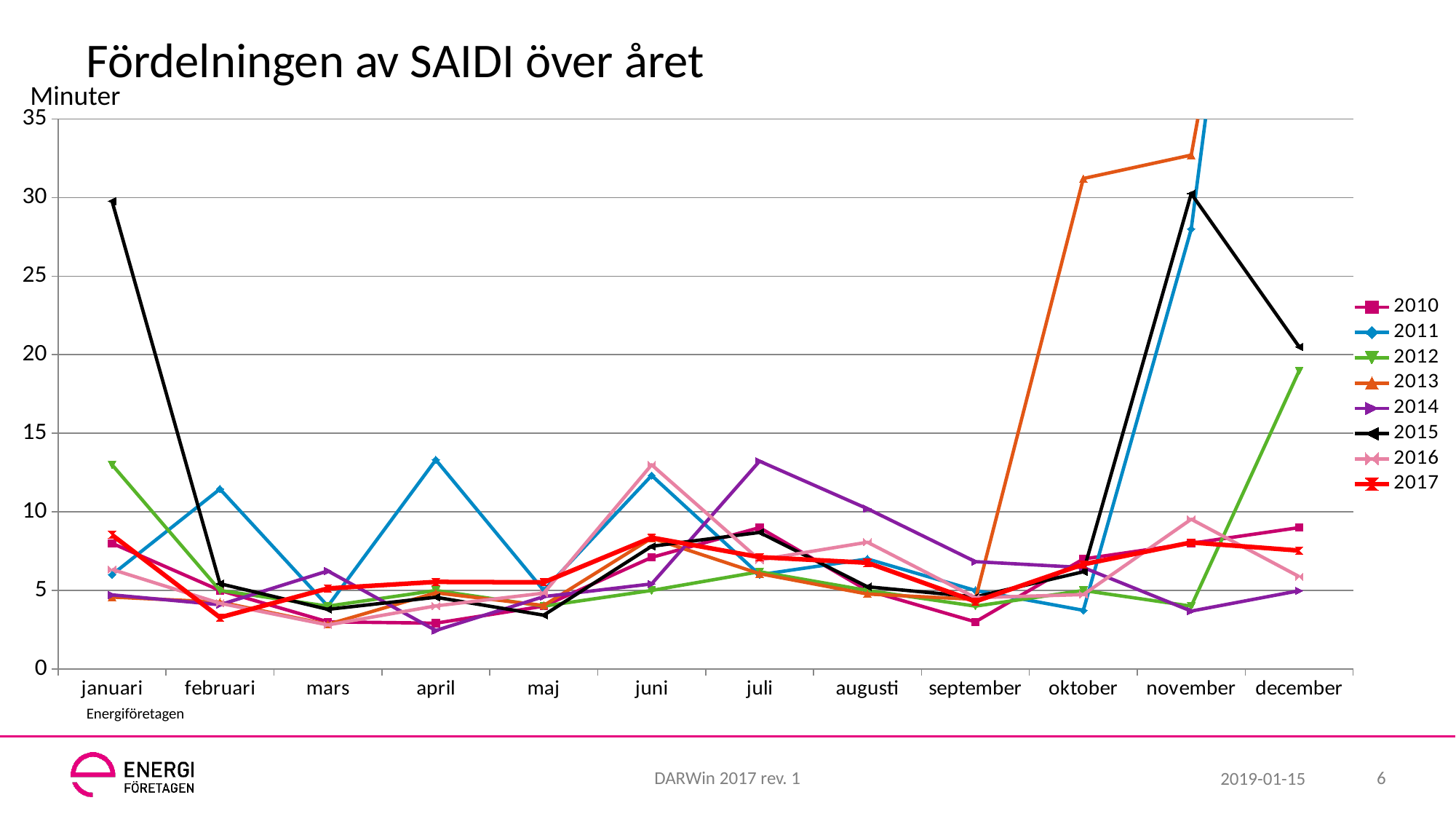
Is the value for 2013 in november greater or less than 30? greater How many series does the legend list? 8 How many months are shown along the x axis? 12 What unit label is shown above the y axis? Minuter Does the 2013 series rise or fall from september to november? rise What kind of chart is shown on the slide? line chart Which is larger in oktober, the value for 2013 or the value for 2017? 2013 Is the value for 2015 in januari greater or less than 25? greater Is the value for 2012 in december greater or less than 15? greater What is the title of the chart? Fördelningen av SAIDI över året Which month has the highest value for the 2014 series? juli